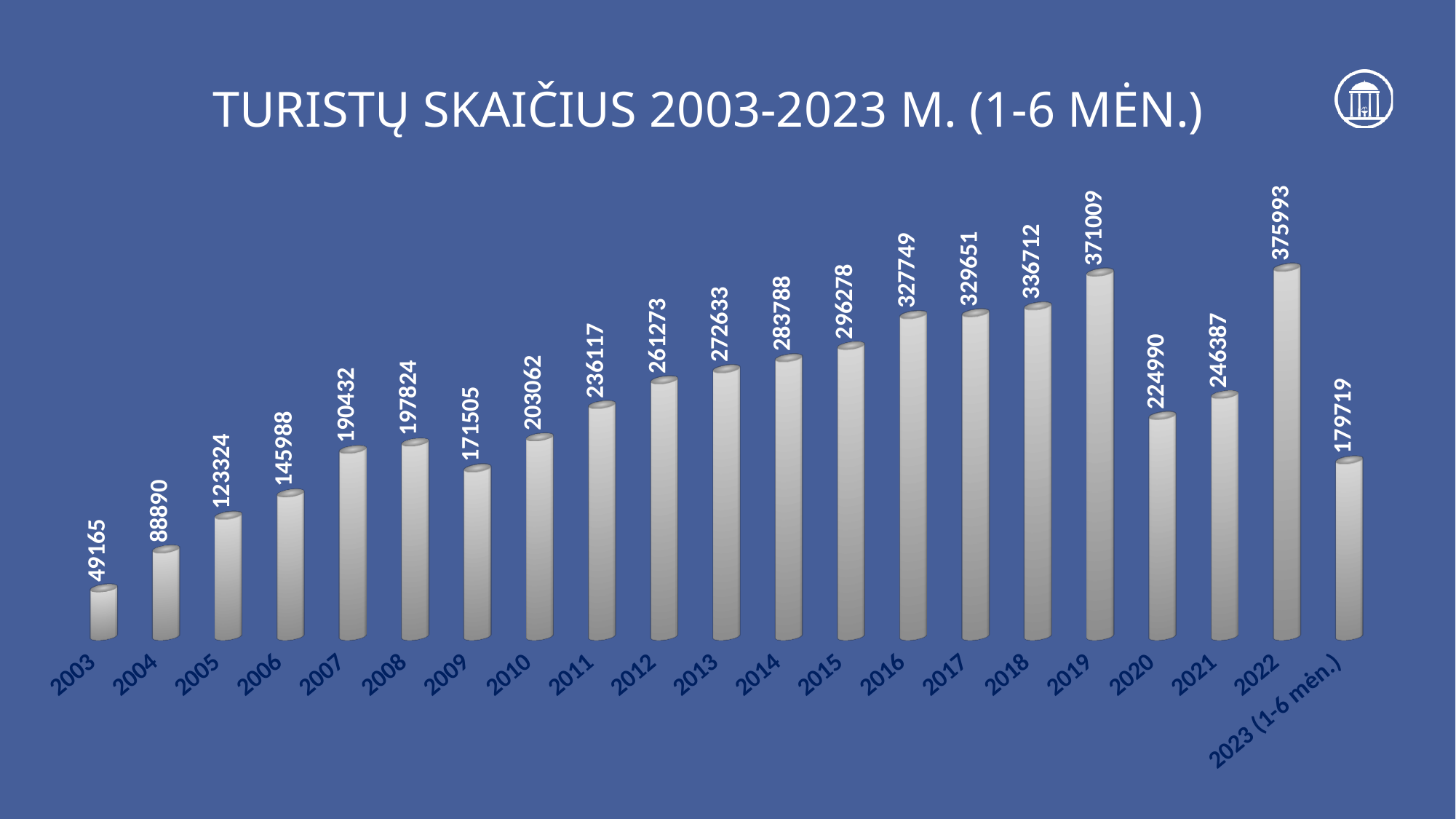
By how much did the value drop from 2019 to 2020? 146019 What type of chart is shown on the slide? Bar chart What is the value for 2009? 171505 What is the number of tourists shown for 2019? 371009 How many bars (categories) are shown in the chart? 21 Which is larger, the value for 2008 or the value for 2009? 2008 What is the difference between the values for 2022 and 2019? 4984 Which is larger, the value for 2020 or the value for 2021? 2021 What value is shown for 2023 (1-6 mėn.)? 179719 Which year has the highest number of tourists? 2022 Which year has the lowest number of tourists? 2003 What is the title of the chart? TURISTŲ SKAIČIUS 2003-2023 M. (1-6 MĖN.)